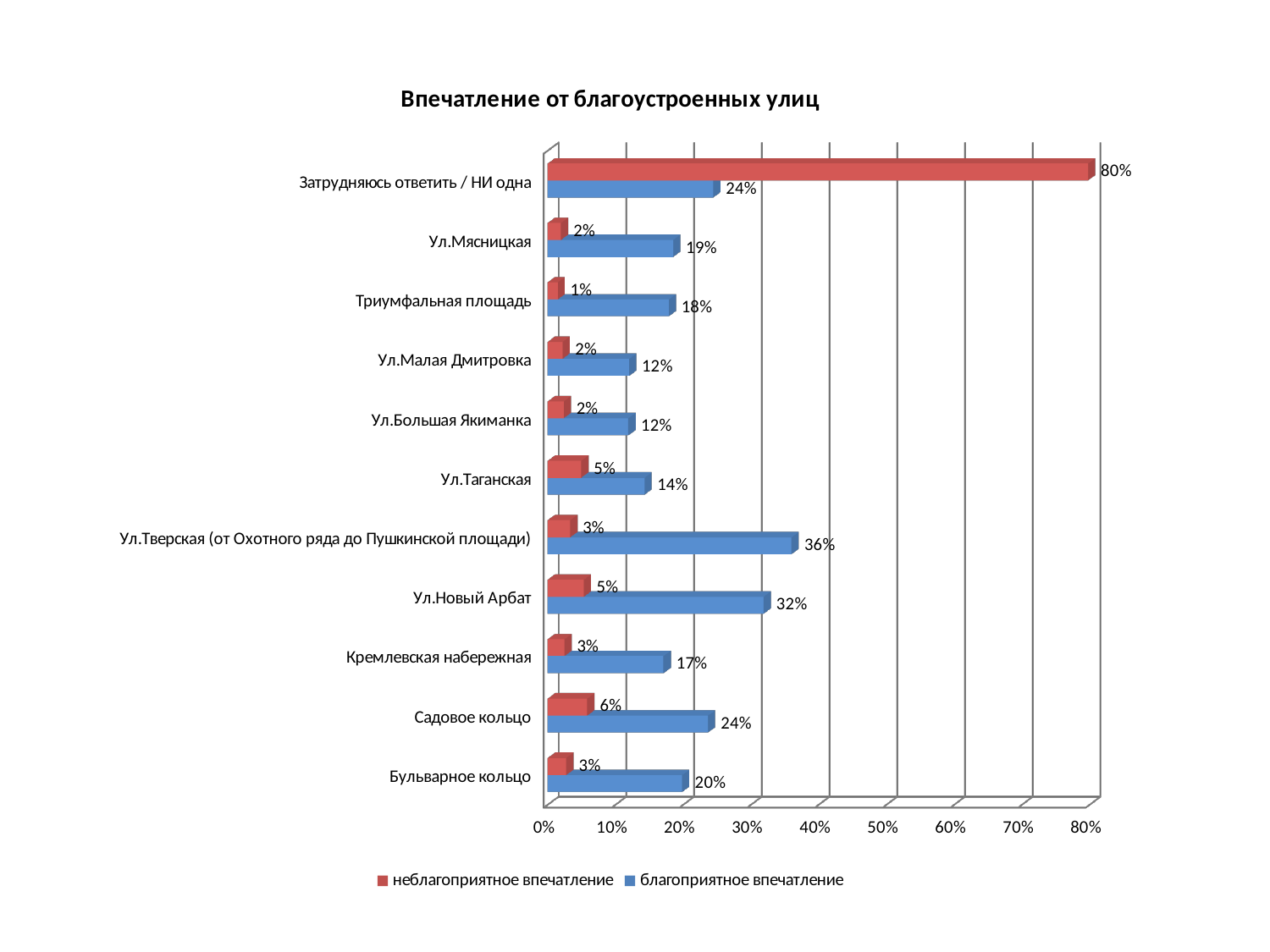
What is the difference between благоприятное впечатление for Ул.Тверская (от Охотного ряда до Пушкинской площади) and Ул.Новый Арбат? 4% How many categories are shown on the chart? 11 Which category has the lowest value for неблагоприятное впечатление? Триумфальная площадь Which colour represents благоприятное впечатление in the chart? Blue What is the title of the chart? Впечатление от благоустроенных улиц Which is larger: благоприятное впечатление for Ул.Мясницкая or for Кремлевская набережная? Ул.Мясницкая What is the value of благоприятное впечатление for Ул.Тверская (от Охотного ряда до Пушкинской площади)? 36% What is the value of неблагоприятное впечатление for Садовое кольцо? 6% What is the value of благоприятное впечатление for Ул.Новый Арбат? 32% How many series does the legend list? 2 What kind of chart is shown on the slide? Bar chart Which category has the highest value for неблагоприятное впечатление? Затрудняюсь ответить / НИ одна